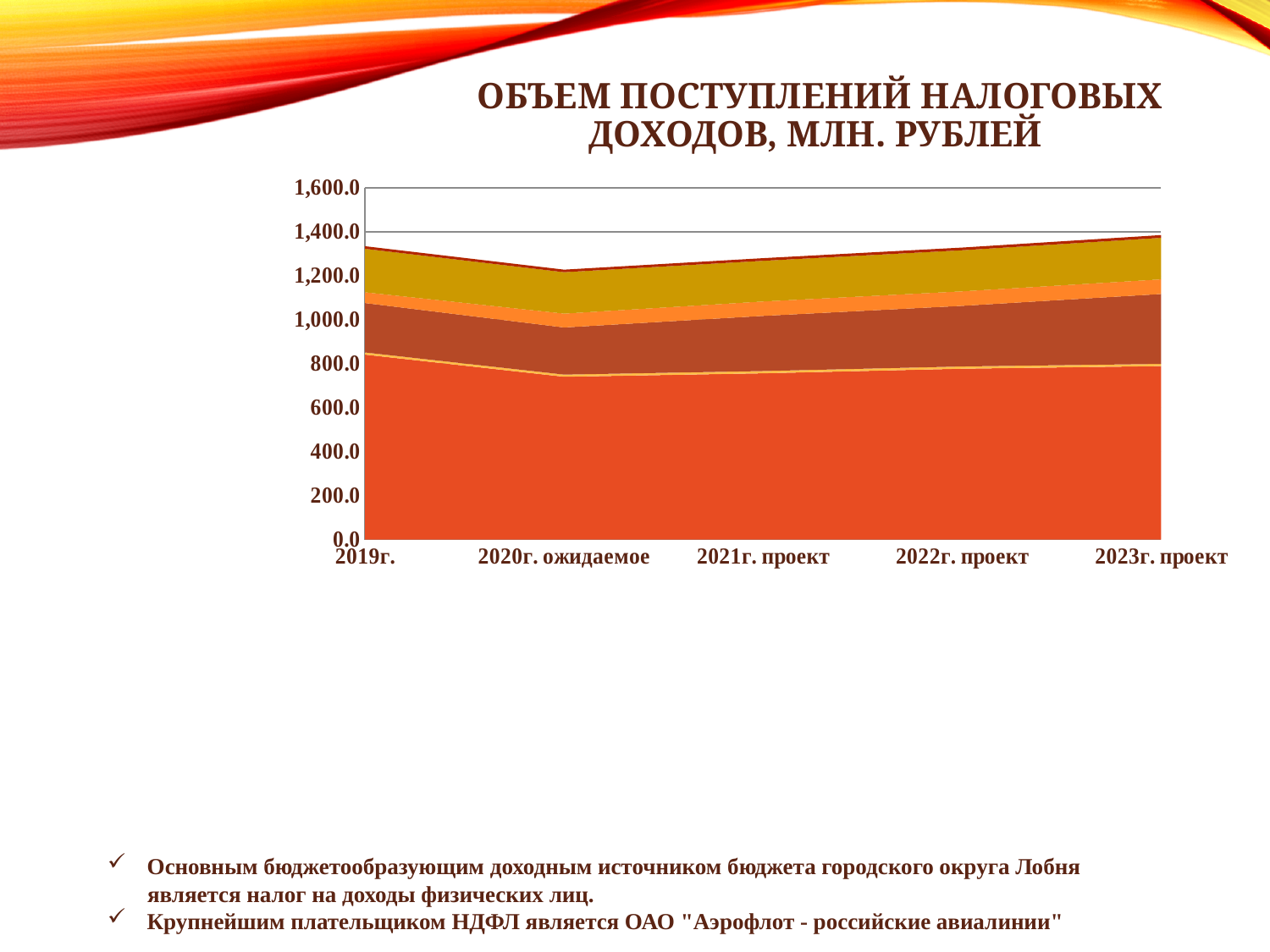
Which category has the lowest total (top of the stacked area)? 2020г. ожидаемое What kind of chart is shown on the slide? Area chart What is the title of the chart? ОБЪЕМ ПОСТУПЛЕНИЙ НАЛОГОВЫХ ДОХОДОВ, МЛН. РУБЛЕЙ In what units are the values on the chart expressed, according to the title? млн. рублей Is the value of the bottom (largest) series for 2020г. ожидаемое greater or less than 800.0? less How many categories are shown along the x axis of the chart? 5 Is the total value for 2019г. greater or less than 1,200.0? greater Does the total value rise or fall from 2019г. to 2020г. ожидаемое? fall Does the total value rise or fall from 2020г. ожидаемое to 2023г. проект? rise Is the total value for 2023г. проект greater or less than 1,200.0? greater